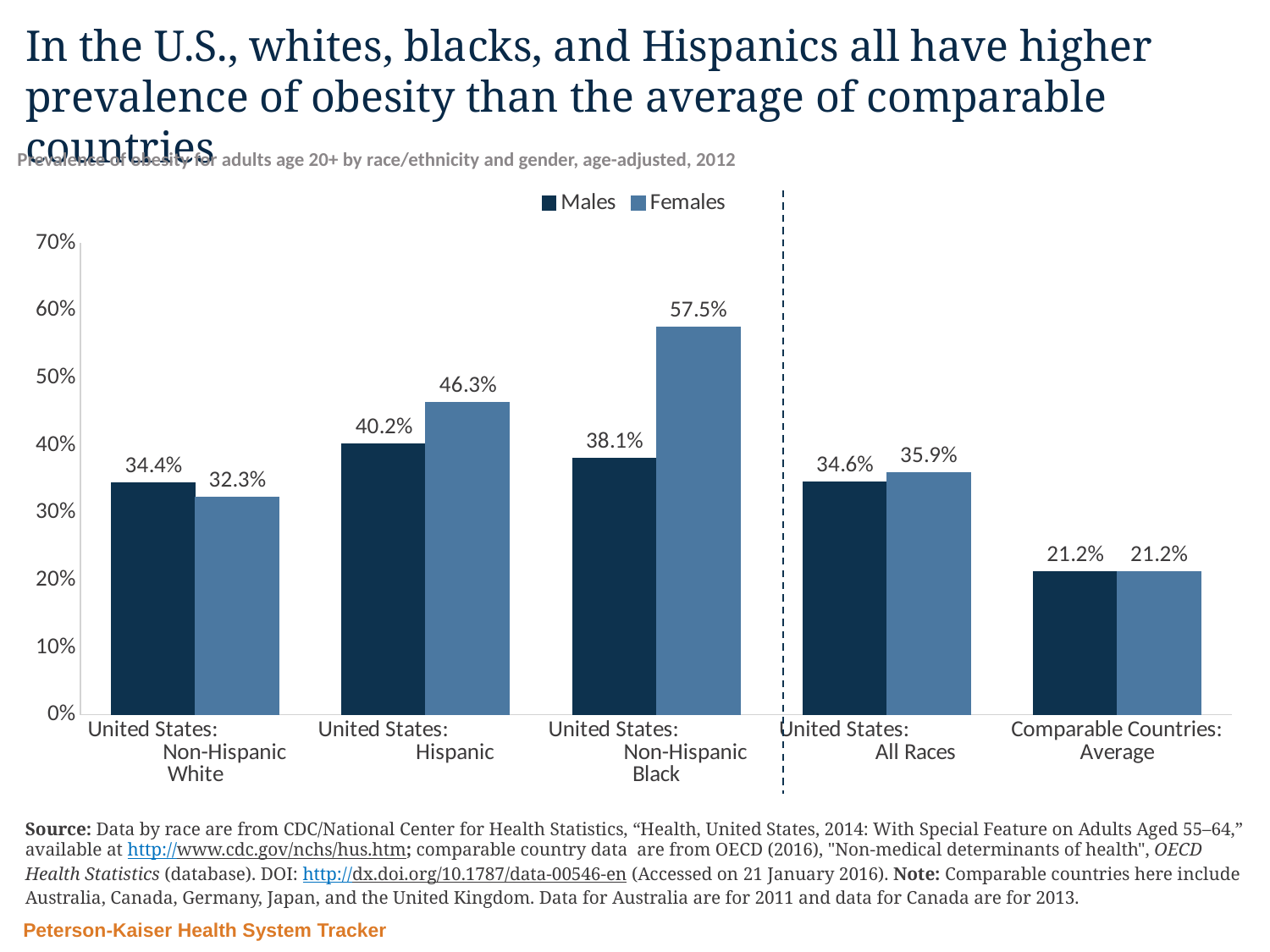
Is the Females value for United States: Hispanic greater or less than 40%? greater What is the obesity prevalence for Females in the United States: Non-Hispanic Black category? 57.5% What is the obesity prevalence for Males in the United States: Hispanic category? 40.2% What is the difference between the Females and Males values for United States: Non-Hispanic Black? 19.4% What is the obesity prevalence for Males in the Comparable Countries: Average category? 21.2% What kind of chart is shown on the slide? Bar chart How many series does the legend list? 2 Which category has the lowest Males value? Comparable Countries: Average How many categories are shown on the x axis? 5 What is the difference between the Males values for United States: All Races and Comparable Countries: Average? 13.4% Which is larger for United States: Non-Hispanic White, the Males value or the Females value? Males Which category has the highest Females value? United States: Non-Hispanic Black